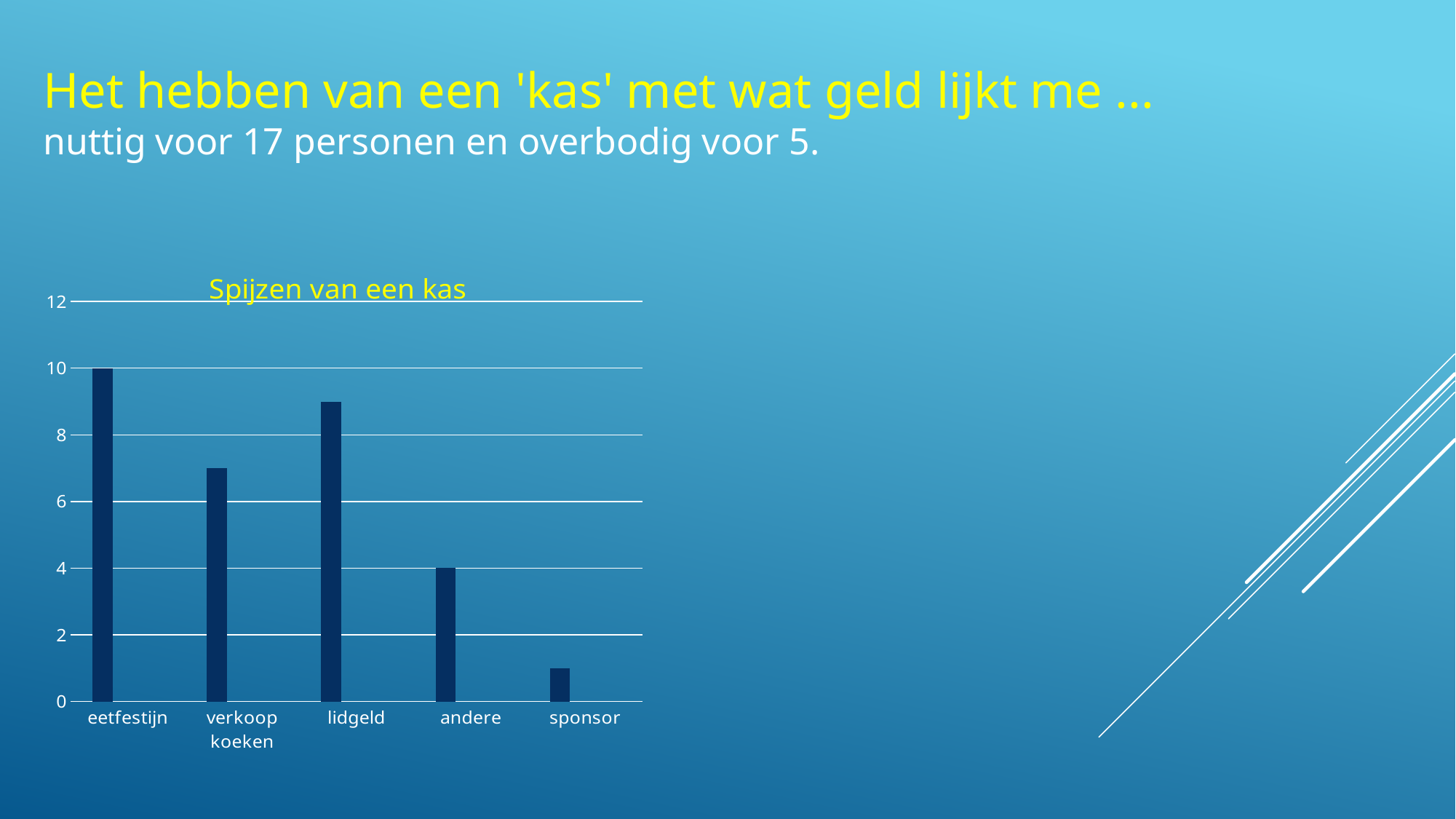
What is the difference between the values for eetfestijn and andere? 6 What is the value for andere? 4 How many categories are shown in the chart? 5 Is the value for sponsor greater or less than 2? less Which is larger, the value for lidgeld or the value for verkoop koeken? lidgeld Is the value for verkoop koeken greater or less than 6? greater Is the value for lidgeld greater or less than 10? less Which category has the highest value? eetfestijn What is the value for eetfestijn? 10 What type of chart is shown on the slide? bar chart What is the title of the chart? Spijzen van een kas Which category has the lowest value? sponsor